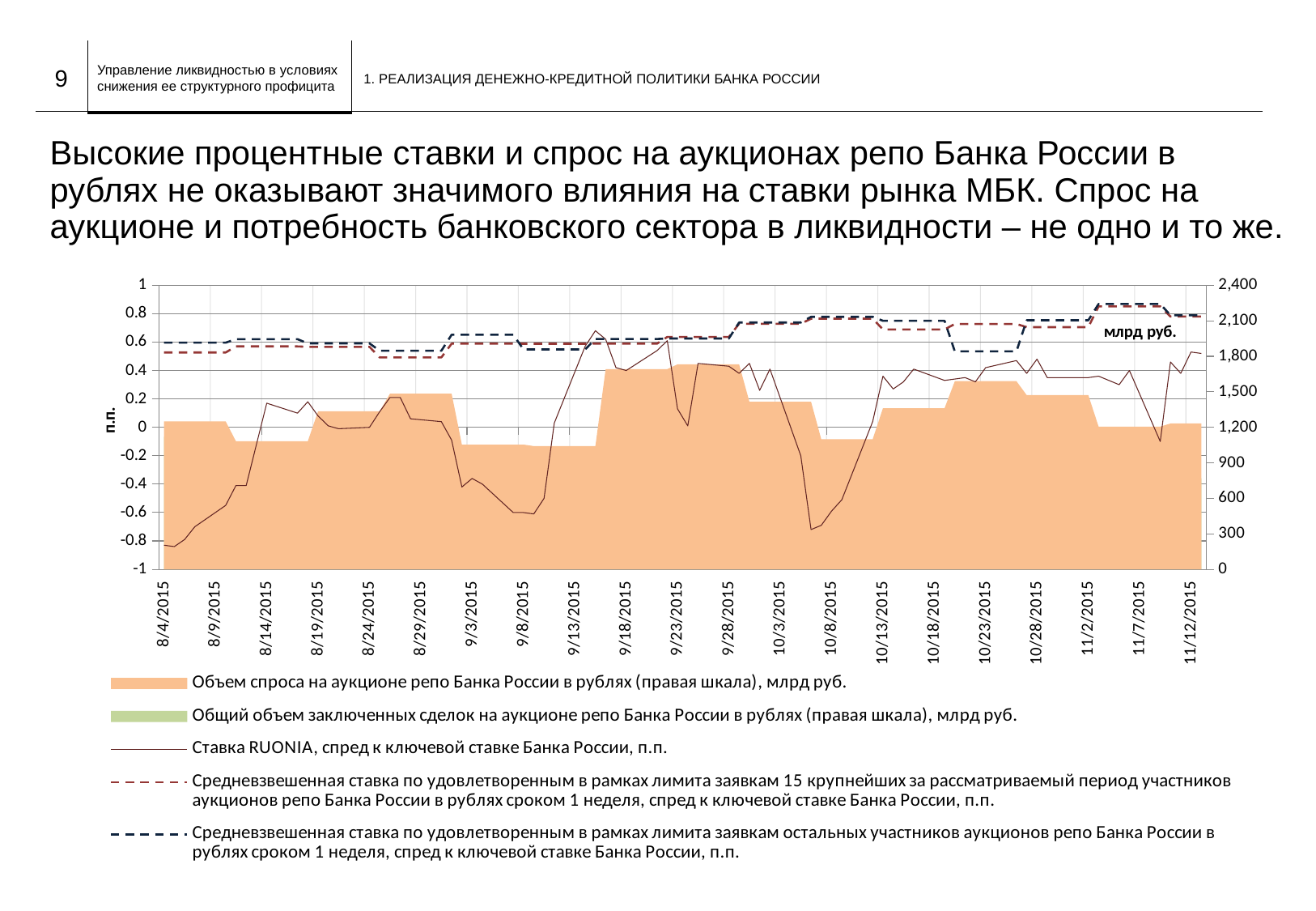
Is the RUONIA spread on 8/4/2015 greater or less than -0.6? less How many date labels are shown along the x axis? 21 How many series does the chart legend list? 5 What kind of chart is used to plot the RUONIA spread series? line chart Is the volume of demand at the repo auction on 10/8/2015 greater or less than 1,200 billion rubles? less What is the label shown for the right vertical axis? млрд руб. Is the volume of demand at the repo auction on 9/18/2015 greater or less than 1,500 billion rubles? greater What is the label of the left vertical axis? п.п. On 10/23/2015, which is higher: the weighted average rate for the 15 largest participants or the rate for the other participants? the 15 largest participants What kind of chart is used to plot the volume of demand at the Bank of Russia repo auction? area chart